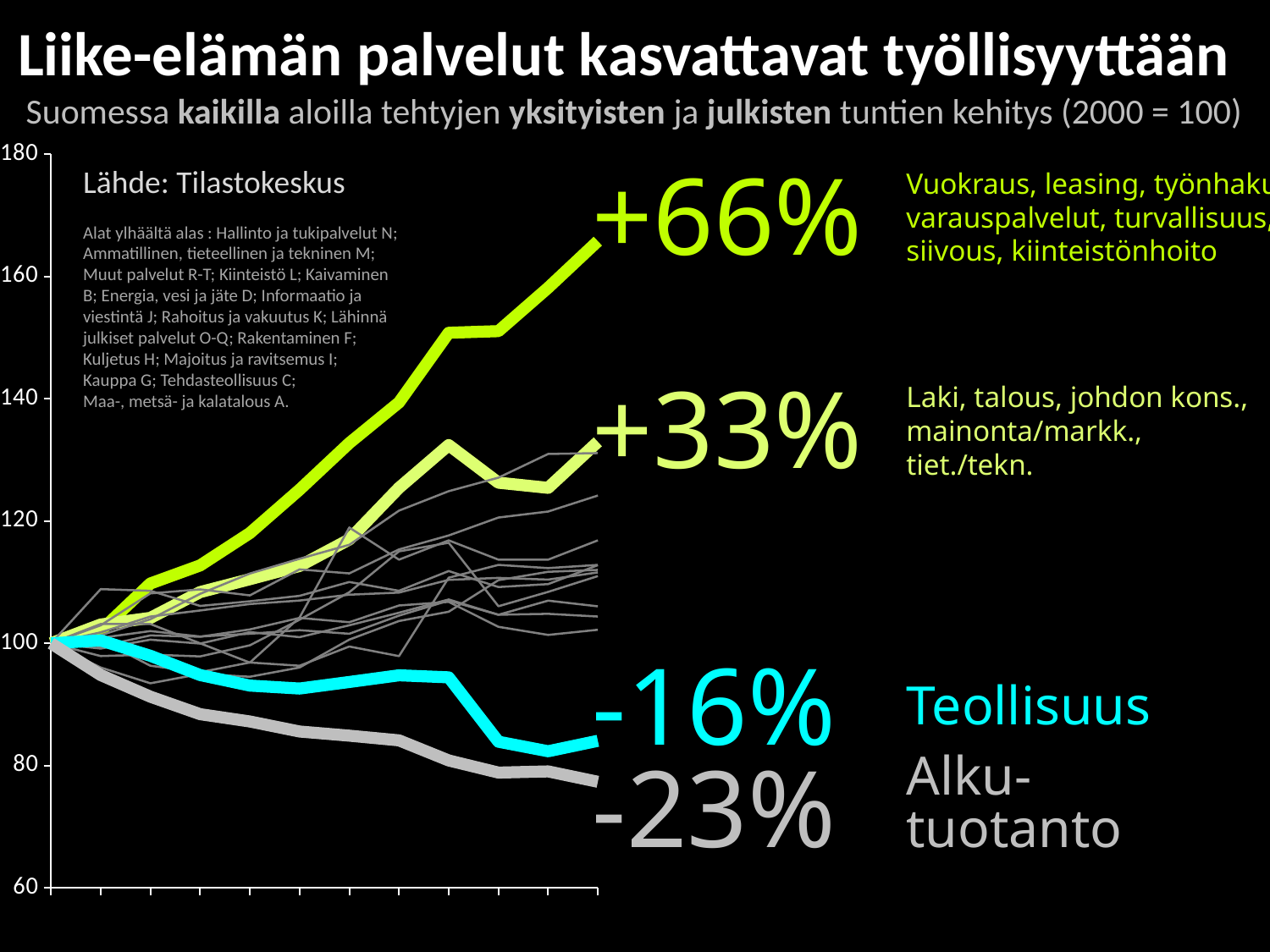
What percentage change is shown for the series labelled 'Vuokraus, leasing, työnhaku, varauspalvelut, turvallisuus, siivous, kiinteistönhoito'? +66% Does the Alkutuotanto line rise or fall along the x axis? fall What kind of chart is shown on the slide? line chart Which of the four annotated series shows the largest decline? Alkutuotanto Is the final value of the Teollisuus line greater or less than 100? less What percentage change is shown for Teollisuus? -16% What source is cited for the chart data? Tilastokeskus Is the final value of the +66% line greater or less than 160? greater Which of the four annotated series shows the largest growth? Vuokraus, leasing, työnhaku, varauspalvelut, turvallisuus, siivous, kiinteistönhoito What is the base year index value stated in the subtitle? 2000 = 100 What percentage change is shown for Alkutuotanto? -23% What percentage change is shown for the series labelled 'Laki, talous, johdon kons., mainonta/markk., tiet./tekn.'? +33%